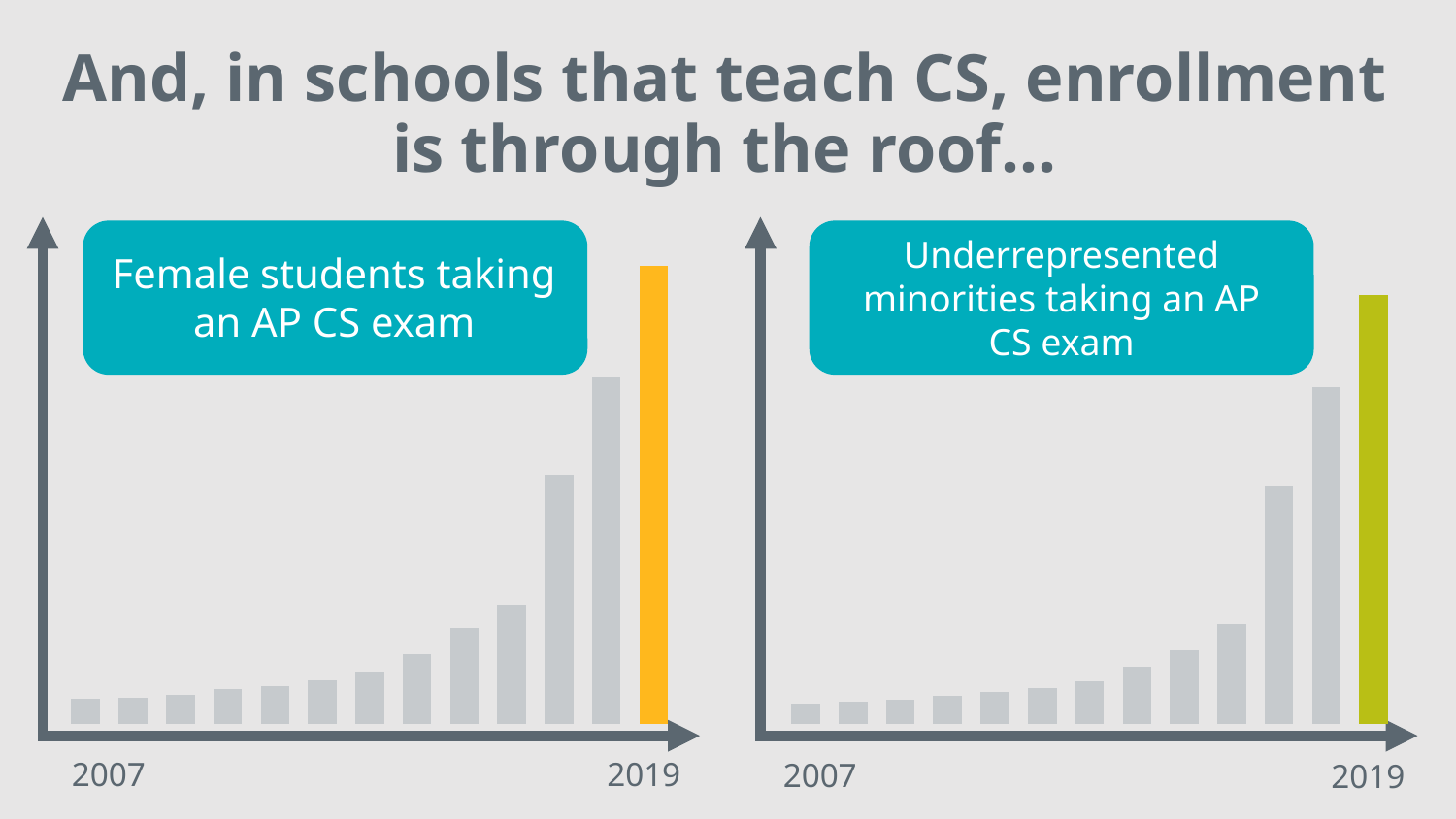
In the right chart, 'Underrepresented minorities taking an AP CS exam', do the values rise or fall from 2007 to 2019? rise In the left chart, 'Female students taking an AP CS exam', which year has the highest bar? 2019 In the right chart, 'Underrepresented minorities taking an AP CS exam', which year has the highest bar? 2019 In the left chart, 'Female students taking an AP CS exam', which is larger, the bar for 2007 or the bar for 2019? 2019 What kind of chart is the left chart, 'Female students taking an AP CS exam'? bar chart What kind of chart is the right chart, 'Underrepresented minorities taking an AP CS exam'? bar chart In the left chart, 'Female students taking an AP CS exam', do the values rise or fall from 2007 to 2019? rise How many bars are plotted in the right chart, 'Underrepresented minorities taking an AP CS exam'? 13 What colour is the highlighted 2019 bar in the left chart, 'Female students taking an AP CS exam'? orange What is the first year labelled on the x axis of the right chart, 'Underrepresented minorities taking an AP CS exam'? 2007 In the right chart, 'Underrepresented minorities taking an AP CS exam', which is larger, the bar for 2007 or the bar for 2019? 2019 How many bars are plotted in the left chart, 'Female students taking an AP CS exam'? 13